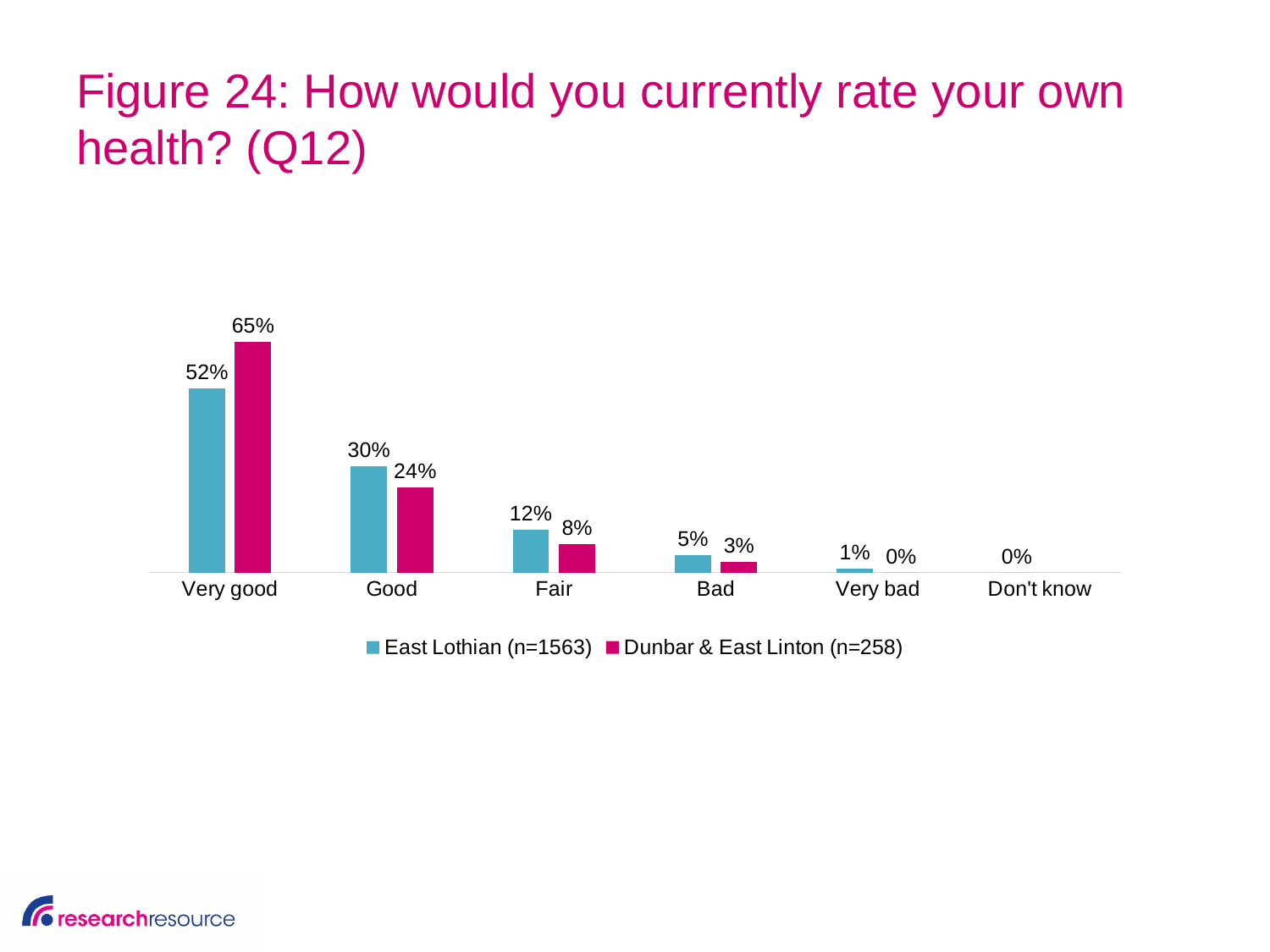
Which category has the lowest value for Dunbar & East Linton? Very bad What is the value for Fair in the East Lothian series? 12% What is the difference between the Dunbar & East Linton and East Lothian values for Very good? 13 percentage points What is the difference between the East Lothian and Dunbar & East Linton values for Good? 6 percentage points What percentage of East Lothian respondents rated their health as Very good? 52% What kind of chart is shown on the slide? Bar chart How many series does the legend list? 2 How many categories are shown on the x axis? 6 What is the value for Good in the Dunbar & East Linton series? 24% What percentage of Dunbar & East Linton respondents rated their health as Very good? 65% Which category has the highest value for East Lothian? Very good Which series has the larger value for Bad, East Lothian or Dunbar & East Linton? East Lothian